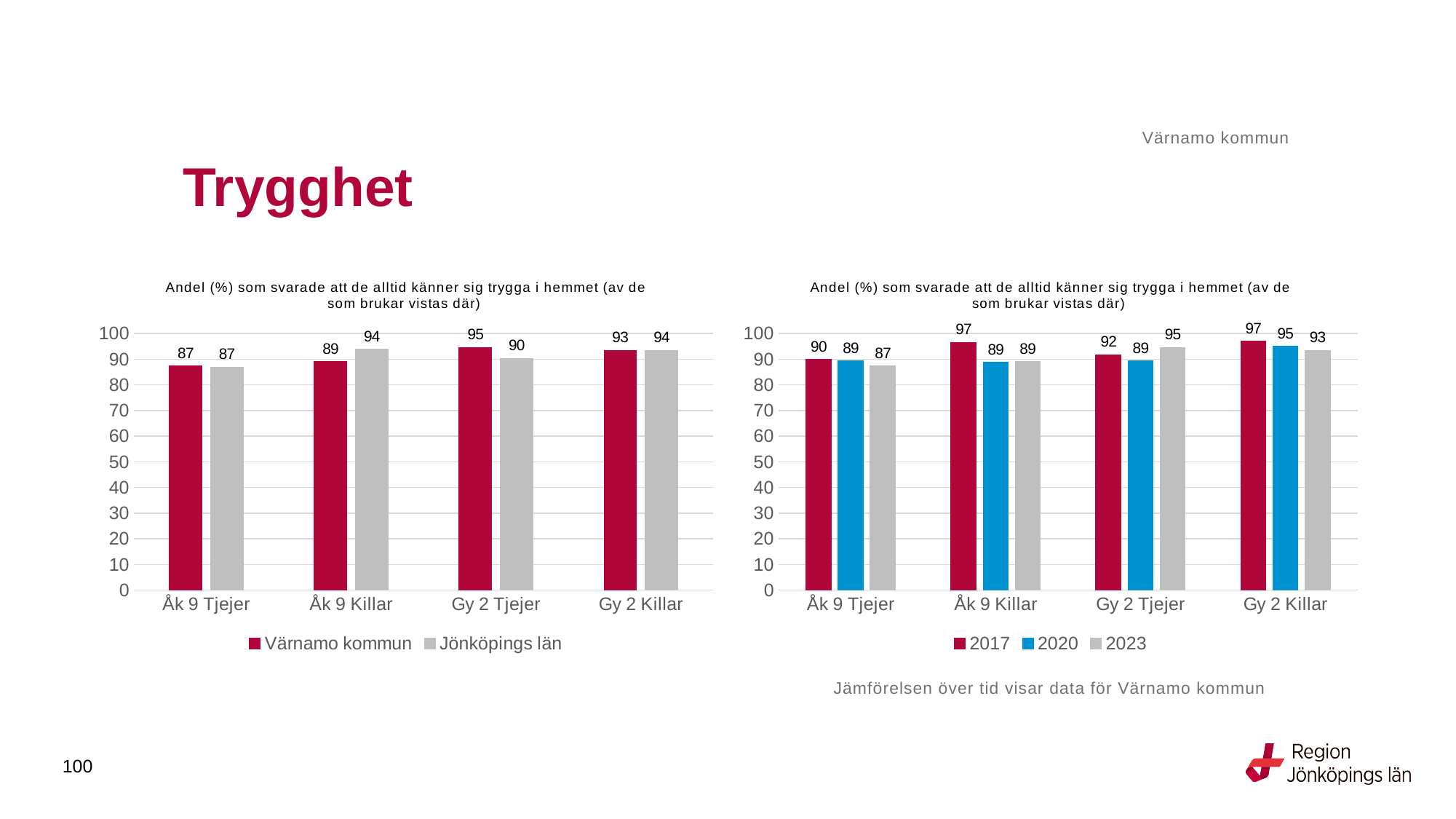
In the left chart, what is the value for Värnamo kommun for Gy 2 Tjejer? 95 In the right chart, which category has the lowest value for 2023? Åk 9 Tjejer In the right chart, which is larger for Gy 2 Killar: 2017 or 2023? 2017 In the right chart, what is the value for 2023 for Gy 2 Tjejer? 95 In the left chart, what is the value for Jönköpings län for Åk 9 Killar? 94 In the right chart, what is the difference between 2017 and 2023 for Åk 9 Killar? 8 What kind of chart is the right chart? Bar chart In the right chart, how many categories are shown on the x axis? 4 In the left chart, how many series does the legend list? 2 In the left chart, what is the difference between Jönköpings län and Värnamo kommun for Åk 9 Killar? 5 In the left chart, which category has the highest value for Värnamo kommun? Gy 2 Tjejer In the right chart, what is the value for 2017 for Åk 9 Killar? 97